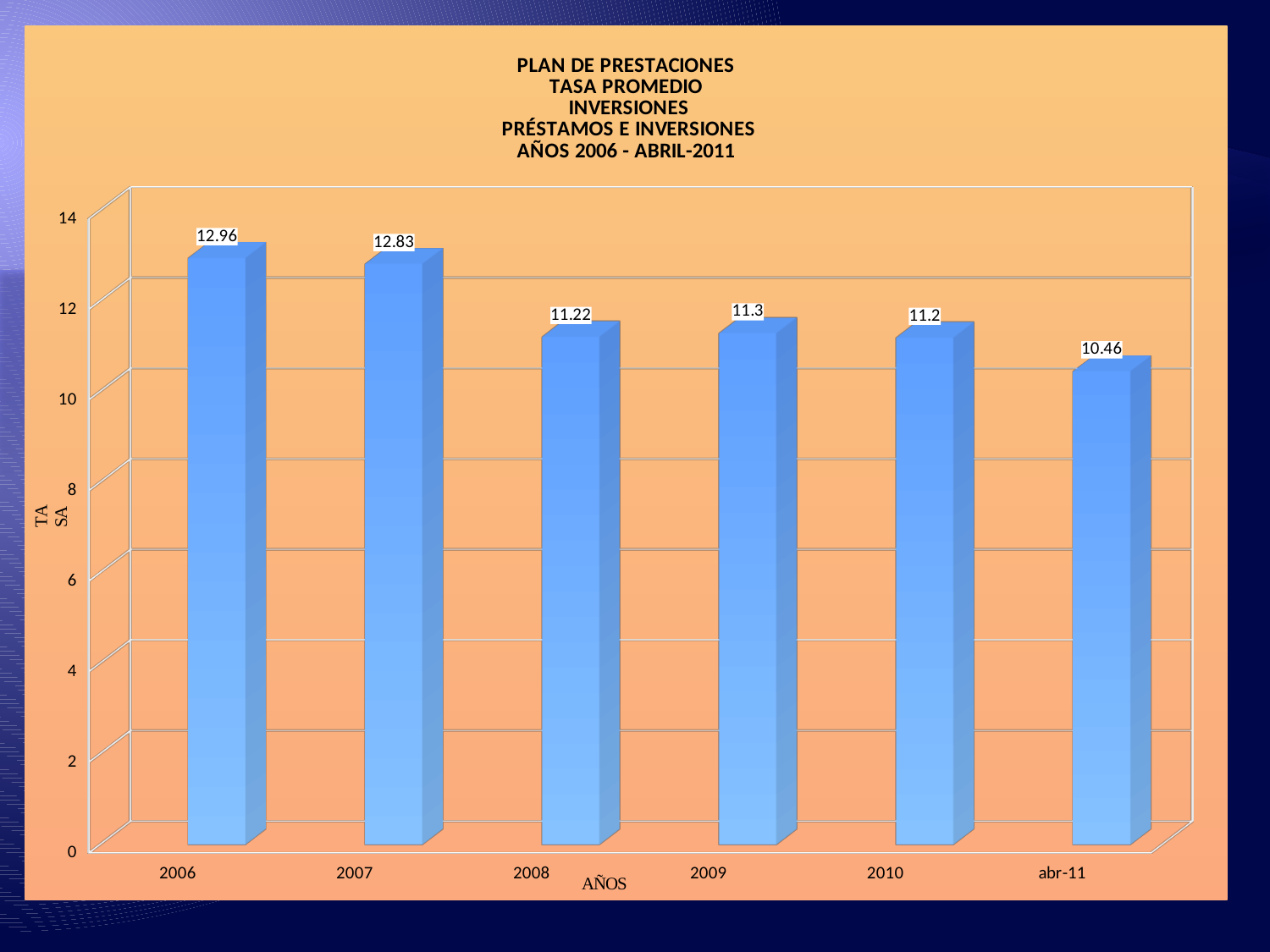
Is the value for 2009 greater or less than 12? less What is the value for 2006? 12.96 What kind of chart is this? bar chart Which is larger, the value for 2007 or the value for 2009? 2007 What is the value for abr-11? 10.46 Which category has the lowest value? abr-11 What is the value for 2008? 11.22 Which year has the highest value? 2006 What is the label of the x axis? AÑOS What is the difference between the values for 2010 and abr-11? 0.74 How many categories are shown on the x axis? 6 What is the difference between the values for 2006 and 2007? 0.13